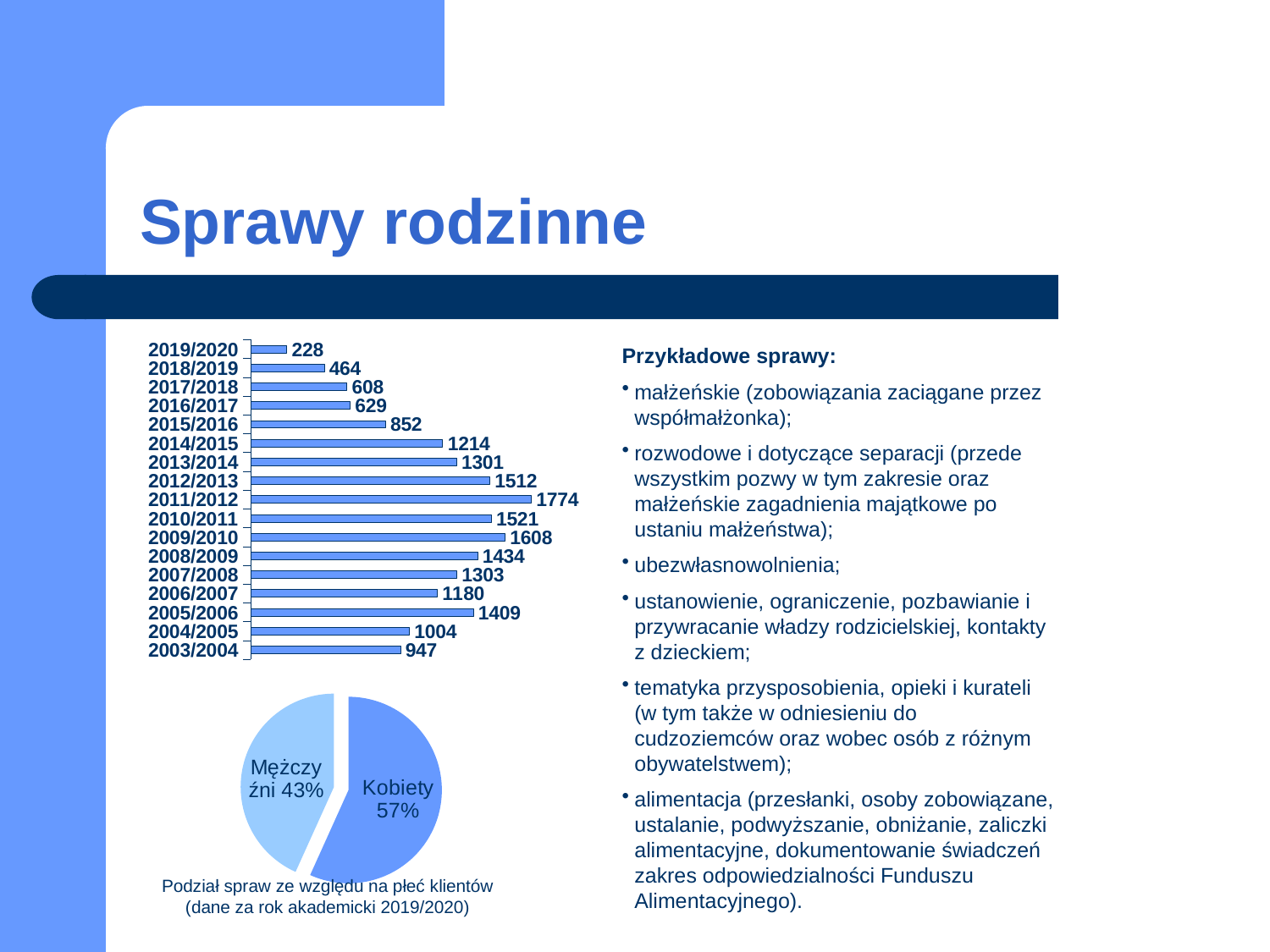
In the bar chart, do the values rise or fall from 2015/2016 to 2019/2020? fall In the bar chart, what is the value for 2003/2004? 947 In the bar chart, what is the difference between the values for 2018/2019 and 2019/2020? 236 In the pie chart, what share of cases is for Kobiety? 57% In the bar chart, which academic year has the lowest value? 2019/2020 In the bar chart, what is the value for 2011/2012? 1774 What kind of chart is the lower chart on the slide? pie chart In the bar chart, which academic year has the highest value? 2011/2012 In the pie chart, what share of cases is for Mężczyźni? 43% How many academic years are shown in the bar chart? 17 In the bar chart, which is larger: the value for 2009/2010 or the value for 2010/2011? 2009/2010 What kind of chart is the upper chart on the slide? bar chart